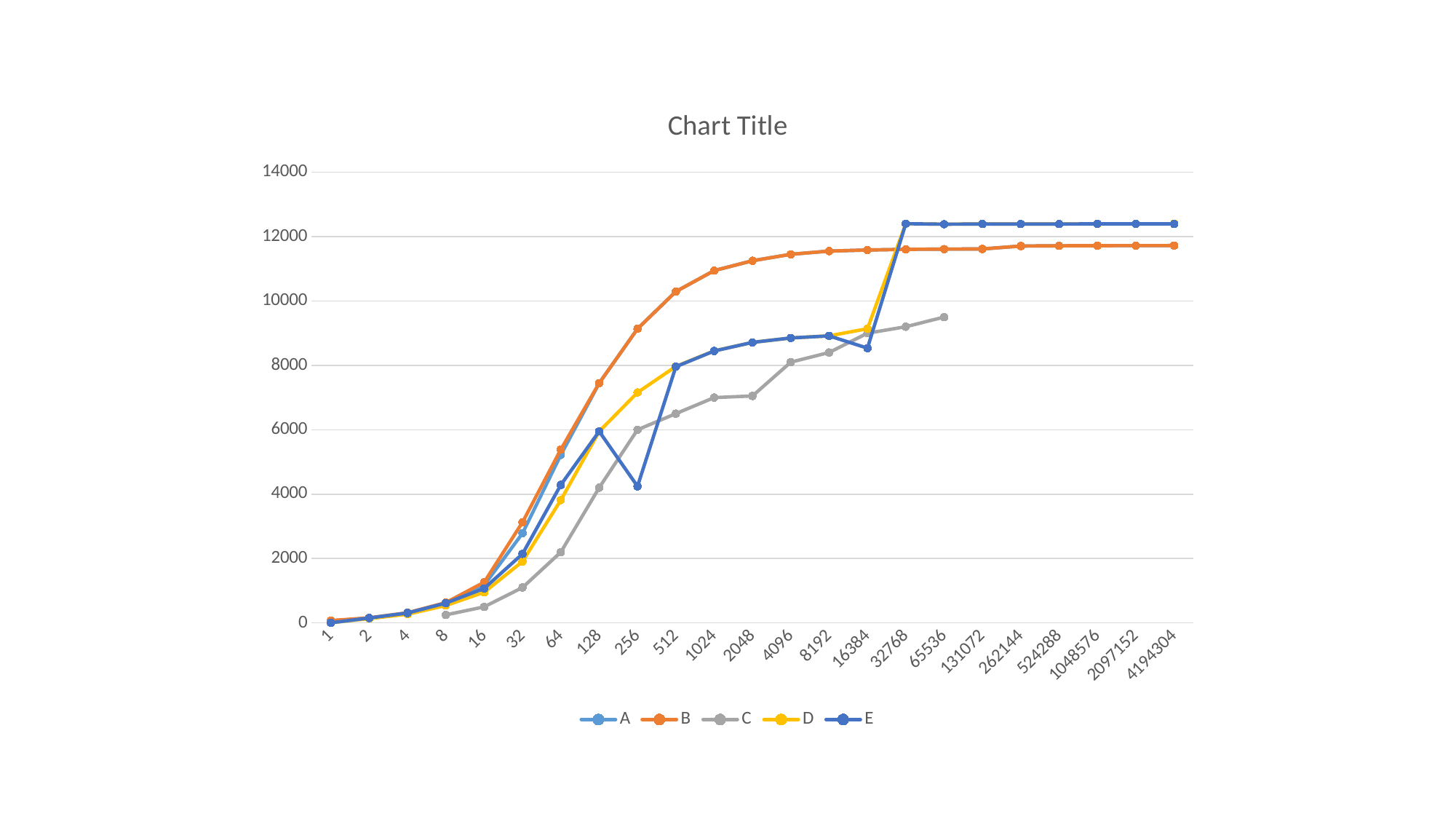
Which series has the lowest value at 1024? C What kind of chart is shown on the slide? line chart What is the title of the chart? Chart Title At 512, which series has the larger value, B or C? B What are the series names listed in the legend? A, B, C, D, E Is the value for series C at 1024 greater or less than 6000? greater How many categories are shown on the x axis? 23 Is the value for series C at 65536 greater or less than 10000? less Is the value for series B at 512 greater or less than 10000? greater Do the values for series B generally rise or fall along the x axis? rise How many series does the legend list? 5